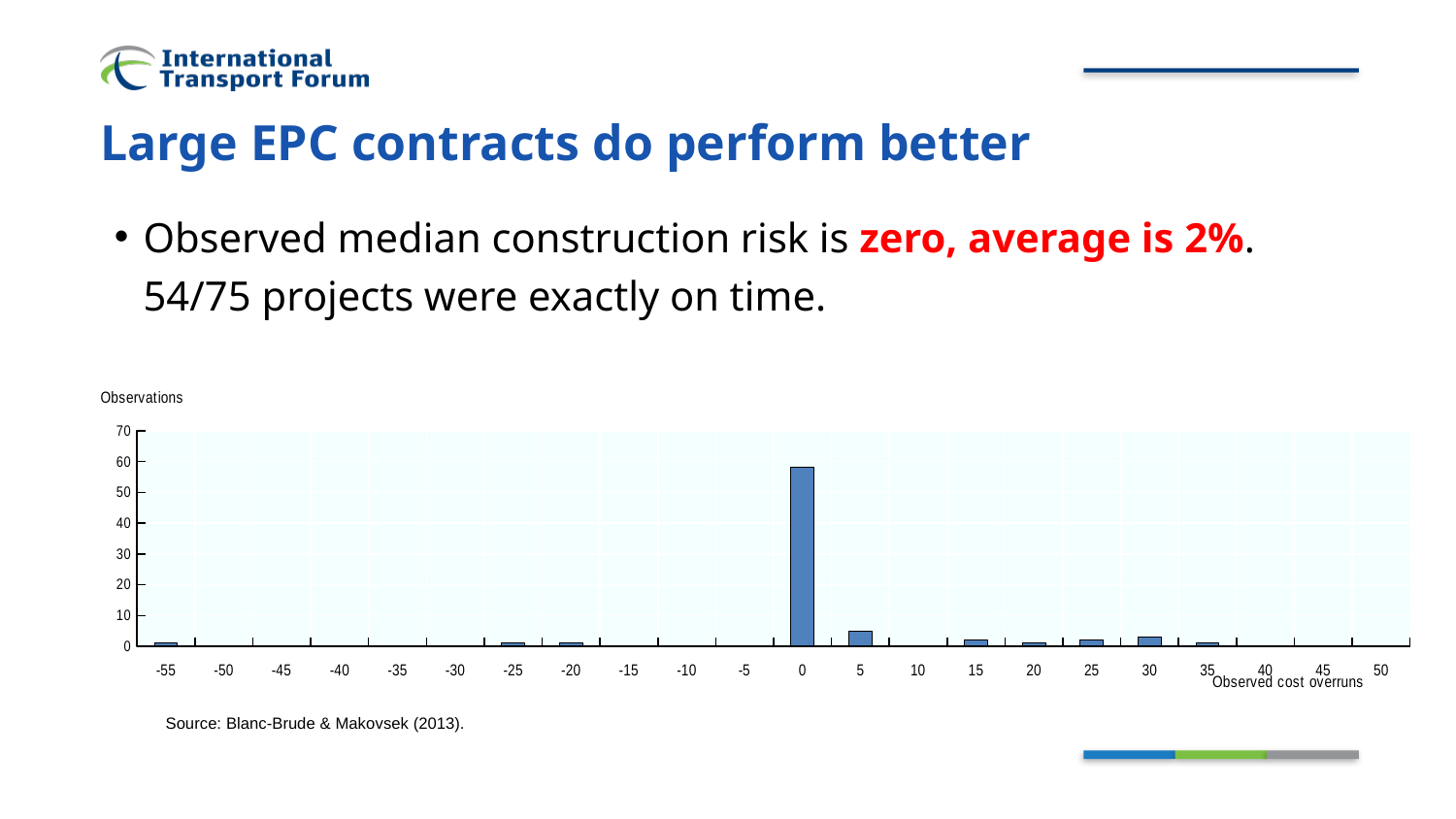
Is the number of observations for the 5 cost overrun category greater or less than 10? less Is the number of observations for the 0 cost overrun category greater or less than 50? greater What is the label of the x axis? Observed cost overruns Which x-axis category has the highest number of observations? 0 What is the label of the y axis? Observations Which has more observations, the 0 category or the 5 category? 0 Is the number of observations for the 30 cost overrun category greater or less than 10? less What kind of chart is shown on the slide? bar chart Which has more observations, the 25 category or the 0 category? 0 What is the highest value shown on the y axis? 70 How many tick labels are shown on the x axis? 22